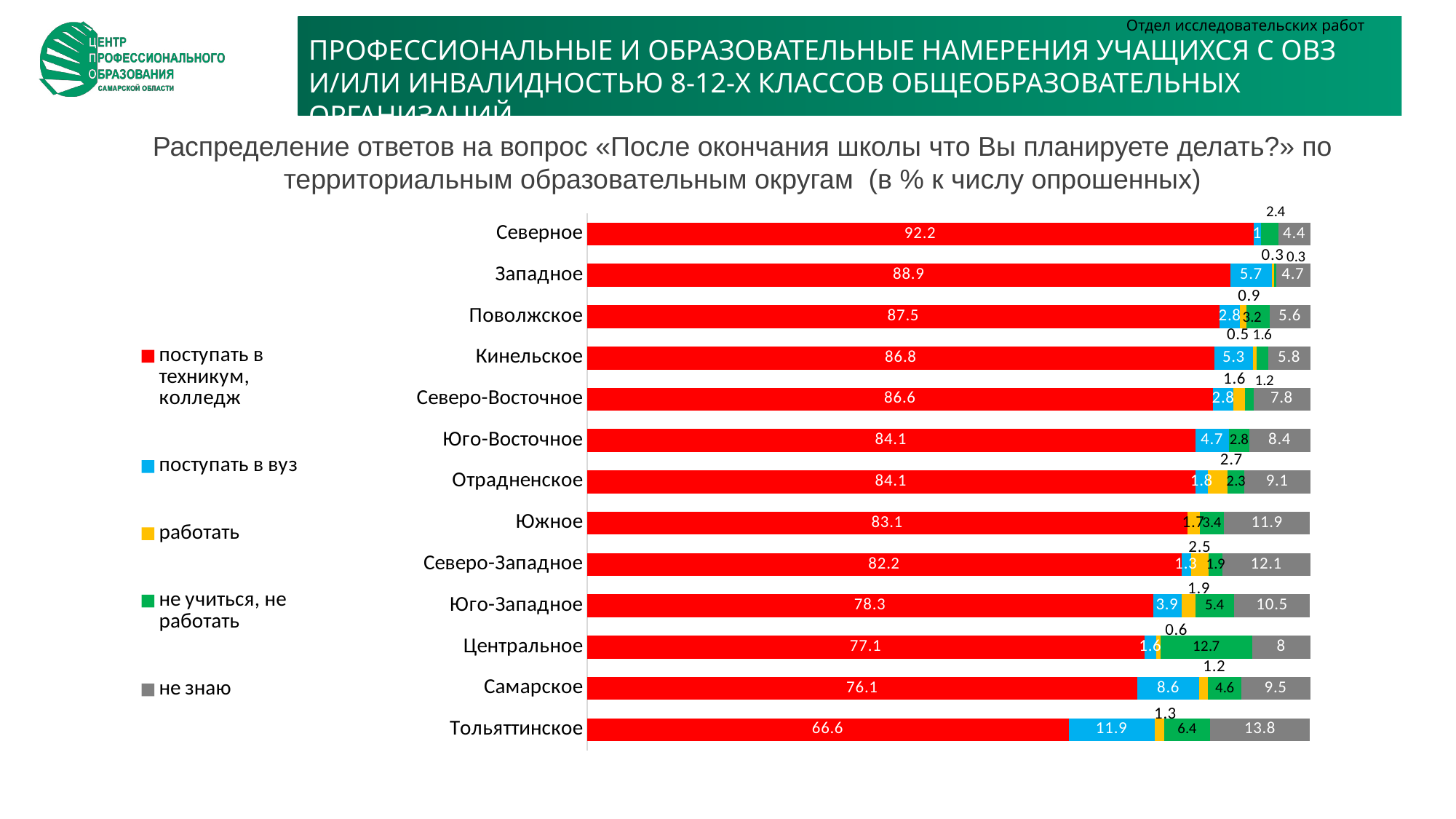
Which district has the lowest value for «поступать в техникум, колледж»? Тольяттинское Which district has the larger «не знаю» value, Южное or Юго-Западное? Южное How many series does the legend list? 5 What is the total of the stacked bar for Самарское? 100 What is the difference between the «поступать в техникум, колледж» values for Северное and Тольяттинское? 25.6 What is the value for «не учиться, не работать» for Центральное? 12.7 How many territorial districts (categories) are shown in the chart? 13 What kind of chart is shown on the slide? stacked bar chart What is the value for «поступать в техникум, колледж» for Северное? 92.2 What is the value for «поступать в вуз» for Самарское? 8.6 Which district has the highest value for «поступать в техникум, колледж»? Северное What is the value for «не знаю» for Тольяттинское? 13.8